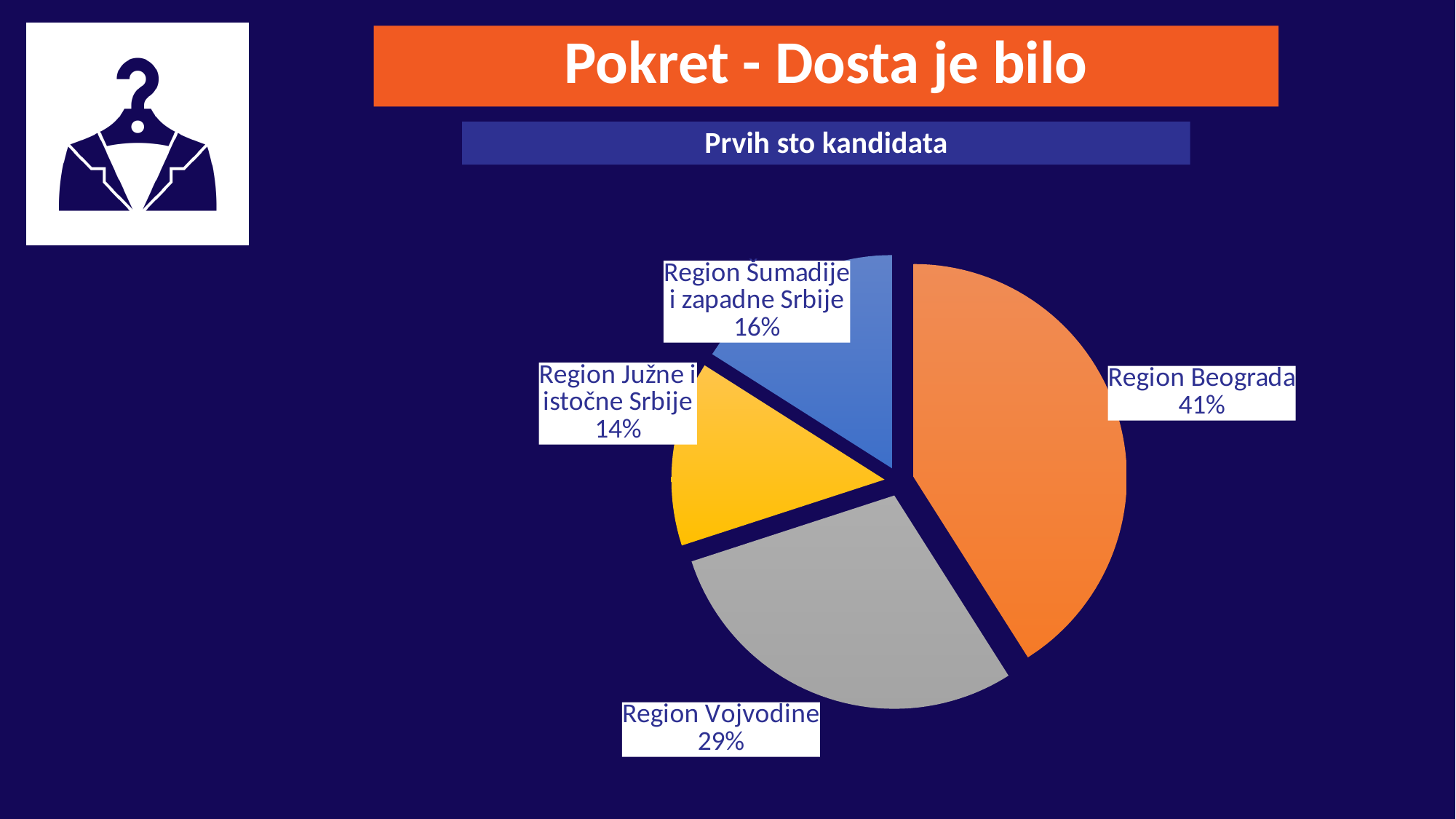
What is the combined share of Region Beograda and Region Vojvodine? 70% What colour is the slice for Region Vojvodine? Grey What kind of chart is shown on the slide? Pie chart Which is larger, the share for Region Šumadije i zapadne Srbije or the share for Region Južne i istočne Srbije? Region Šumadije i zapadne Srbije What share of the pie does Region Šumadije i zapadne Srbije have? 16% What is the difference in percentage points between Region Beograda and Region Vojvodine? 12 Which region has the largest slice of the pie? Region Beograda What share of the pie does Region Južne i istočne Srbije have? 14% What share of the pie does Region Beograda have? 41% How many slices does the pie chart have? 4 What share of the pie does Region Vojvodine have? 29% Which region has the smallest slice of the pie? Region Južne i istočne Srbije